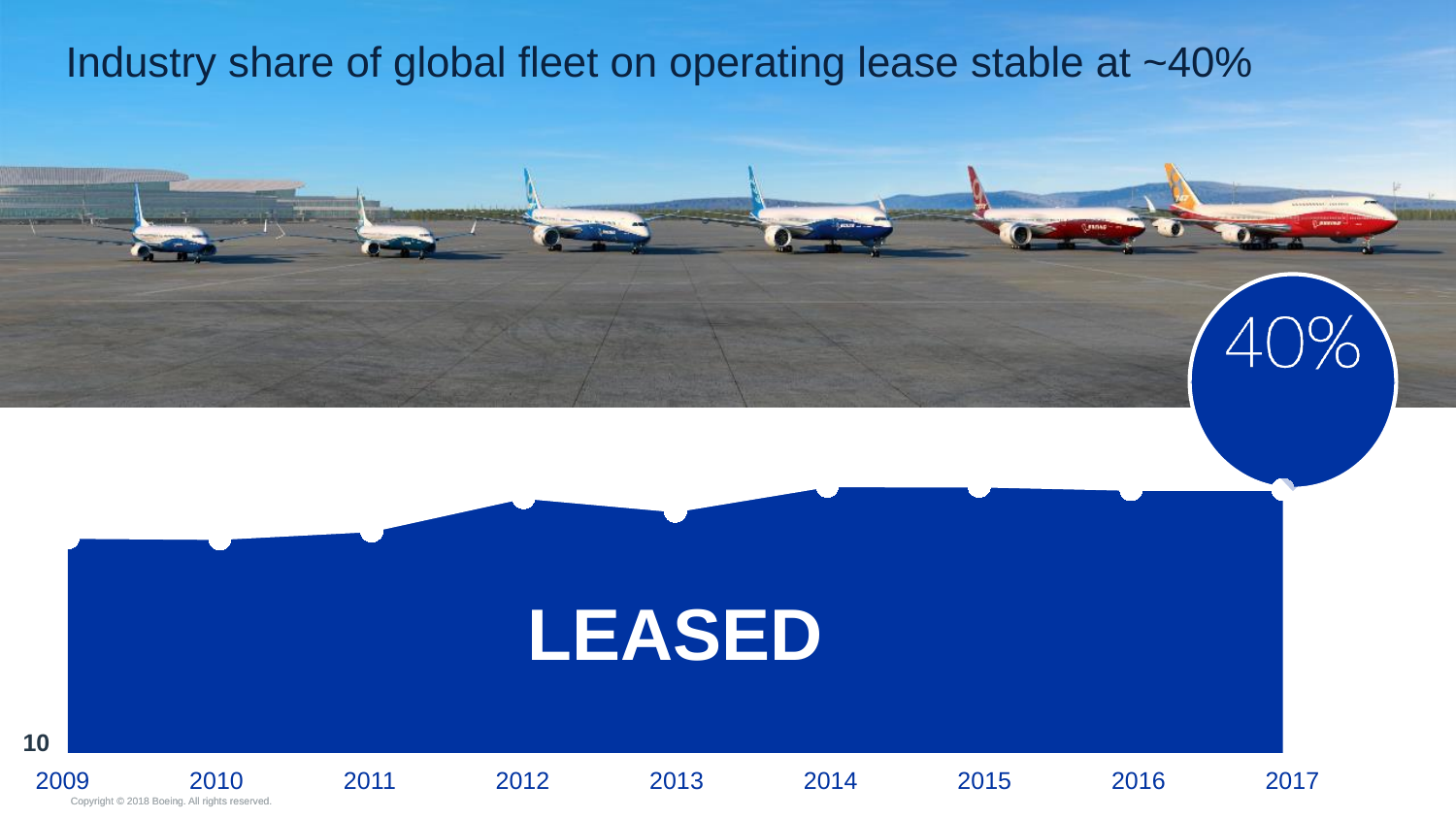
What is the title of the slide containing the chart? Industry share of global fleet on operating lease stable at ~40% Does the leased share generally rise or fall from 2009 to 2017? rise What is the last year shown on the x axis of the chart? 2017 Which is larger, the value for 2009 or the value for 2017? 2017 What value is called out for 2017 on the chart? 40% Which is larger, the value for 2010 or the value for 2012? 2012 What kind of chart is shown on the slide? area chart How many years are shown on the x axis of the chart? 9 What is the first year shown on the x axis of the chart? 2009 Which is larger, the value for 2011 or the value for 2014? 2014